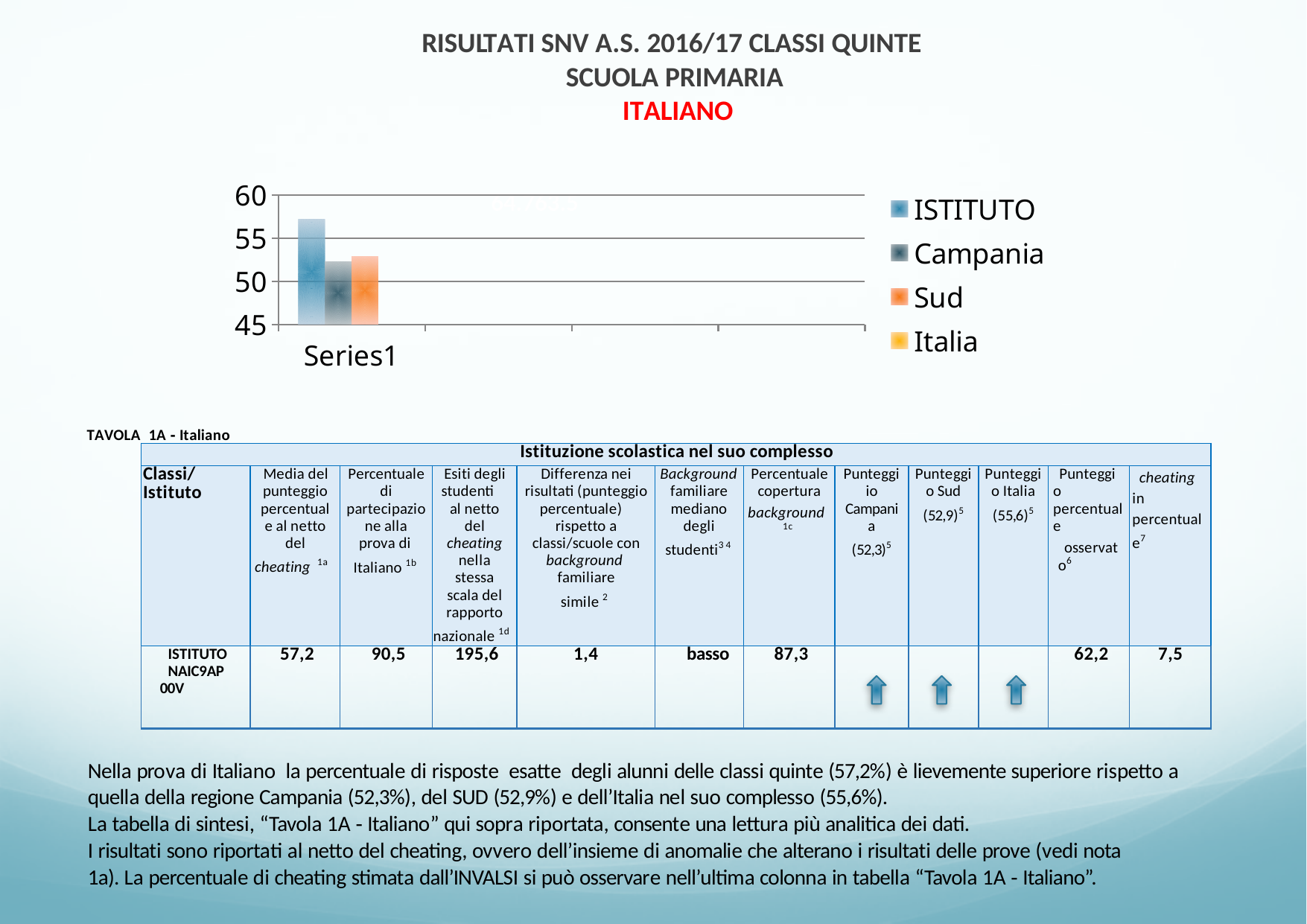
What is the category label shown on the x axis of the chart? Series1 What kind of chart is shown on the slide? bar chart Is the value for Campania greater or less than 50? greater Is the value for ISTITUTO greater or less than 60? less Which legend entry is listed last in the chart legend? Italia How many series does the chart legend list? 4 Is the value for Campania greater or less than 55? less Which is larger, the bar for ISTITUTO or the bar for Sud? ISTITUTO Which series has the tallest bar in the chart? ISTITUTO Which is larger, the bar for ISTITUTO or the bar for Campania? ISTITUTO